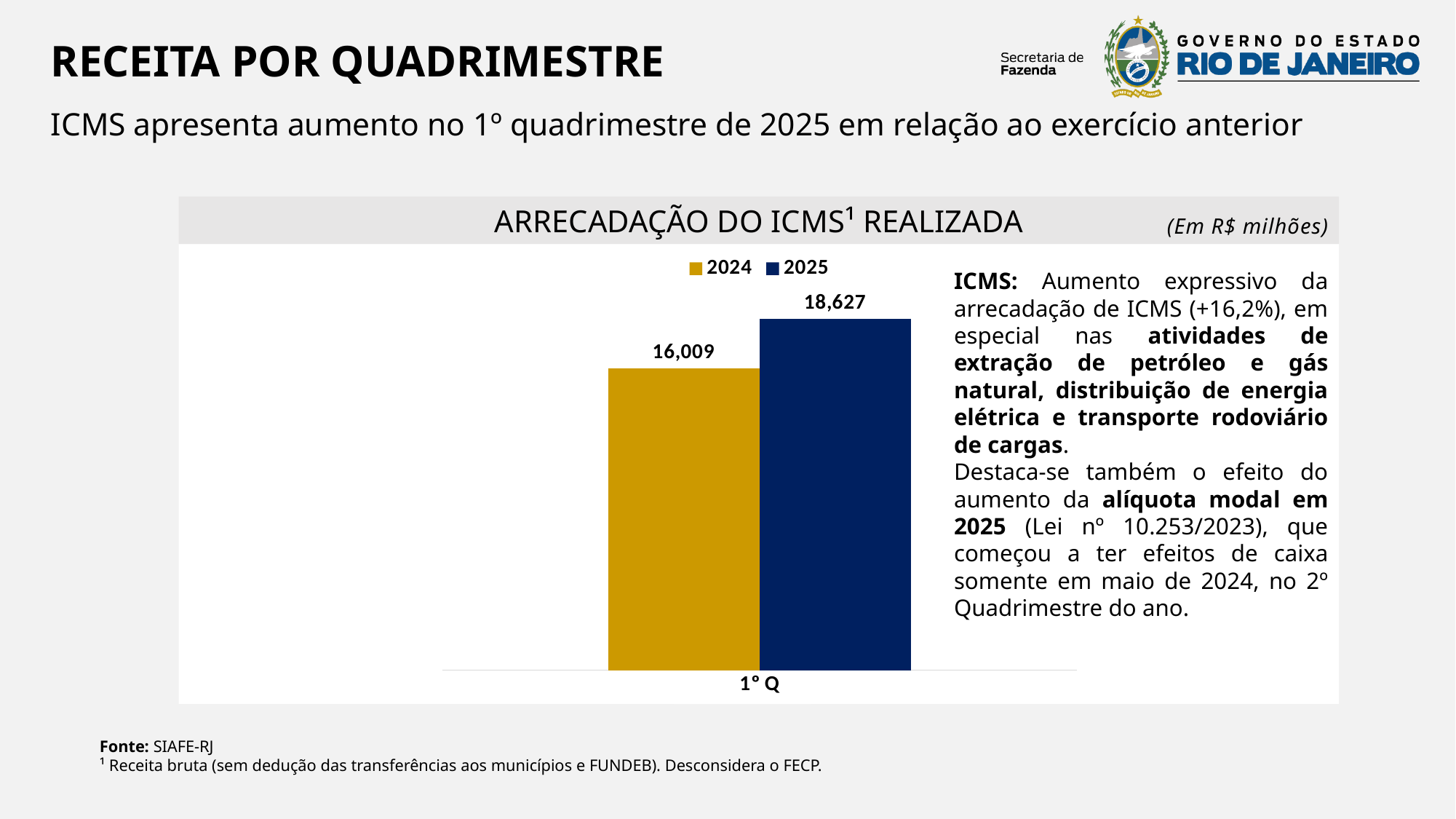
What unit is stated for the chart values? Em R$ milhões What kind of chart is shown on the slide? Bar chart Which series has the highest value in the chart? 2025 What is the value for 2025 in the 1º Q category? 18,627 What is the value for 2024 in the 1º Q category? 16,009 How many categories are shown on the x axis? 1 Which series has the higher value for 1º Q, 2024 or 2025? 2025 What is the label of the single category on the x axis? 1º Q What is the difference between the 2025 and 2024 values for 1º Q? 2,618 What is the title of the chart? ARRECADAÇÃO DO ICMS¹ REALIZADA Which series has the lowest value in the chart? 2024 How many series does the legend list? 2